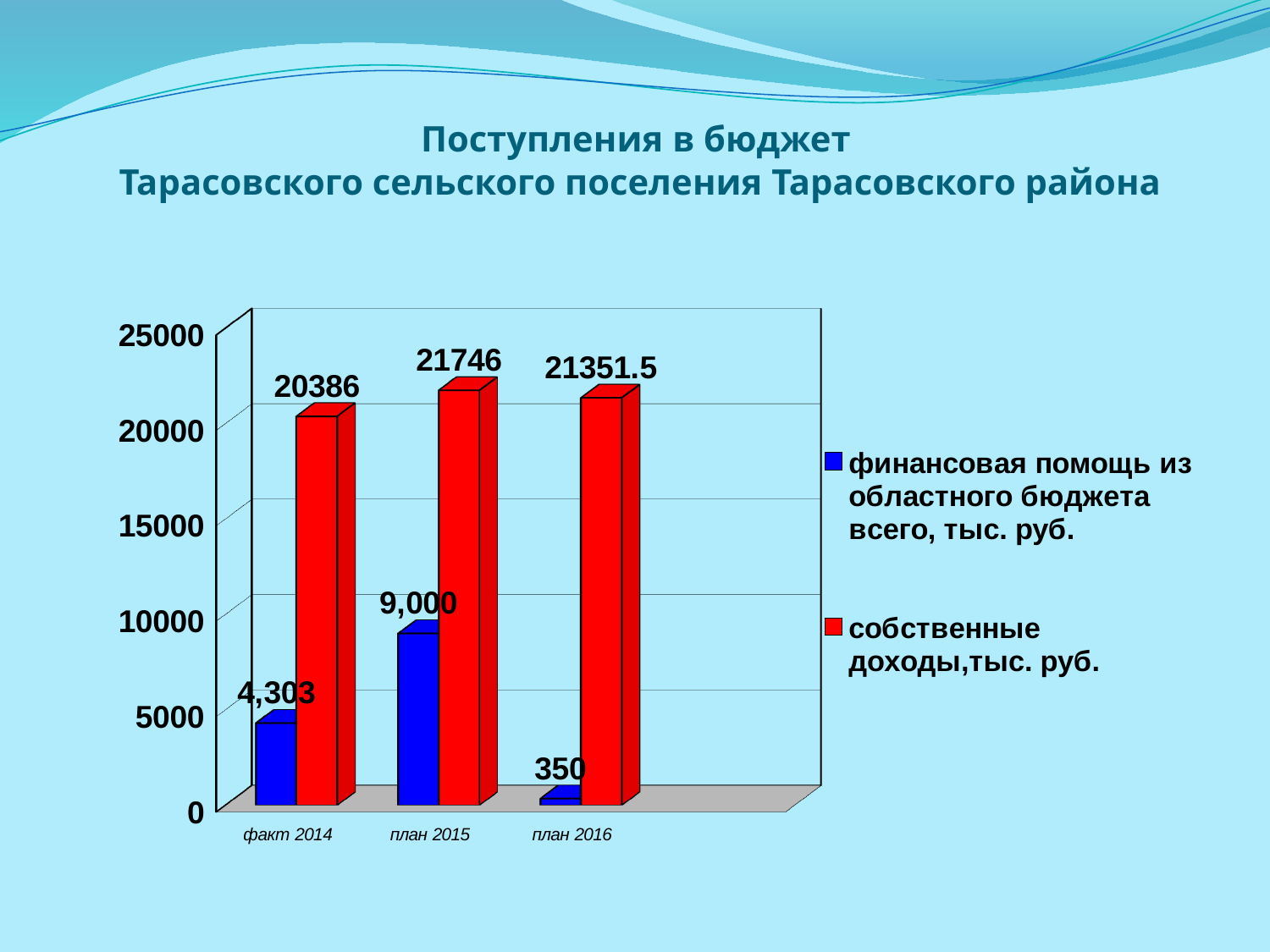
What is the value of собственные доходы for факт 2014? 20386 What is the value of собственные доходы for план 2016? 21351.5 Which series is shown in red? собственные доходы,тыс. руб. Which is larger: финансовая помощь из областного бюджета for факт 2014 or for план 2015? план 2015 How many categories are shown on the x axis? 3 What is the value of финансовая помощь из областного бюджета for план 2016? 350 What is the value of финансовая помощь из областного бюджета for план 2015? 9,000 What is the difference between собственные доходы for план 2015 and факт 2014? 1360 In which category is финансовая помощь из областного бюджета the lowest? план 2016 What type of chart is shown on the slide? bar chart How many series does the legend list? 2 In which category is собственные доходы the highest? план 2015